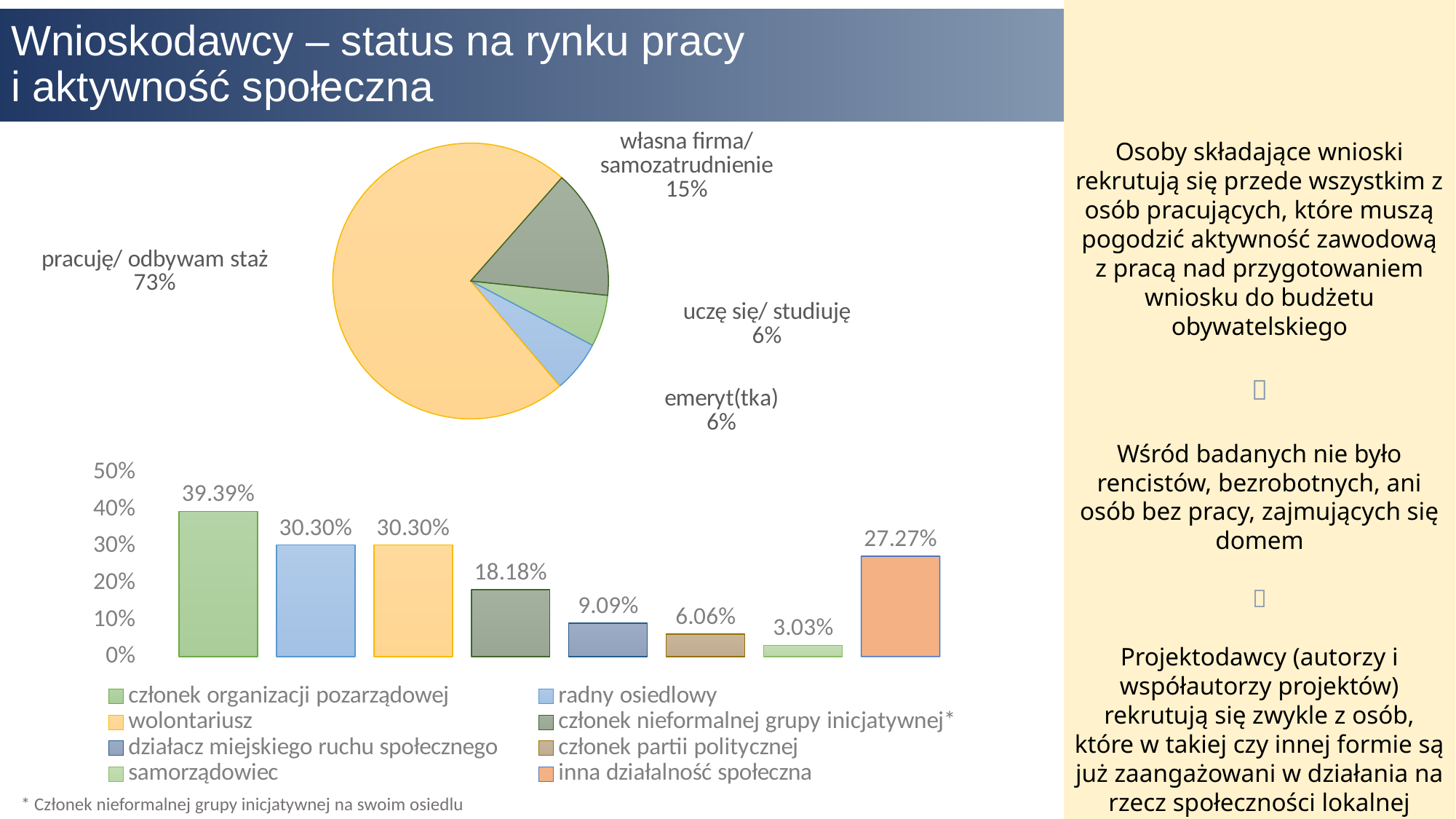
In the bar chart at the bottom, which is larger: 'działacz miejskiego ruchu społecznego' or 'członek partii politycznej'? działacz miejskiego ruchu społecznego What type of chart is shown at the bottom of the slide? bar chart In the bar chart at the bottom, which category has the lowest value? samorządowiec In the pie chart at the top, what share is shown for 'własna firma/ samozatrudnienie'? 15% In the pie chart at the top, how many slices are there? 4 In the pie chart at the top, what share is shown for 'pracuję/ odbywam staż'? 73% In the pie chart at the top, which category has the largest slice? pracuję/ odbywam staż In the bar chart at the bottom, how many entries does the legend list? 8 In the bar chart at the bottom, what is the difference between 'członek organizacji pozarządowej' and 'członek nieformalnej grupy inicjatywnej*'? 21.21% In the bar chart at the bottom, what is the value for 'członek organizacji pozarządowej'? 39.39% In the bar chart at the bottom, what is the value for 'inna działalność społeczna'? 27.27% In the bar chart at the bottom, which category has the highest value? członek organizacji pozarządowej